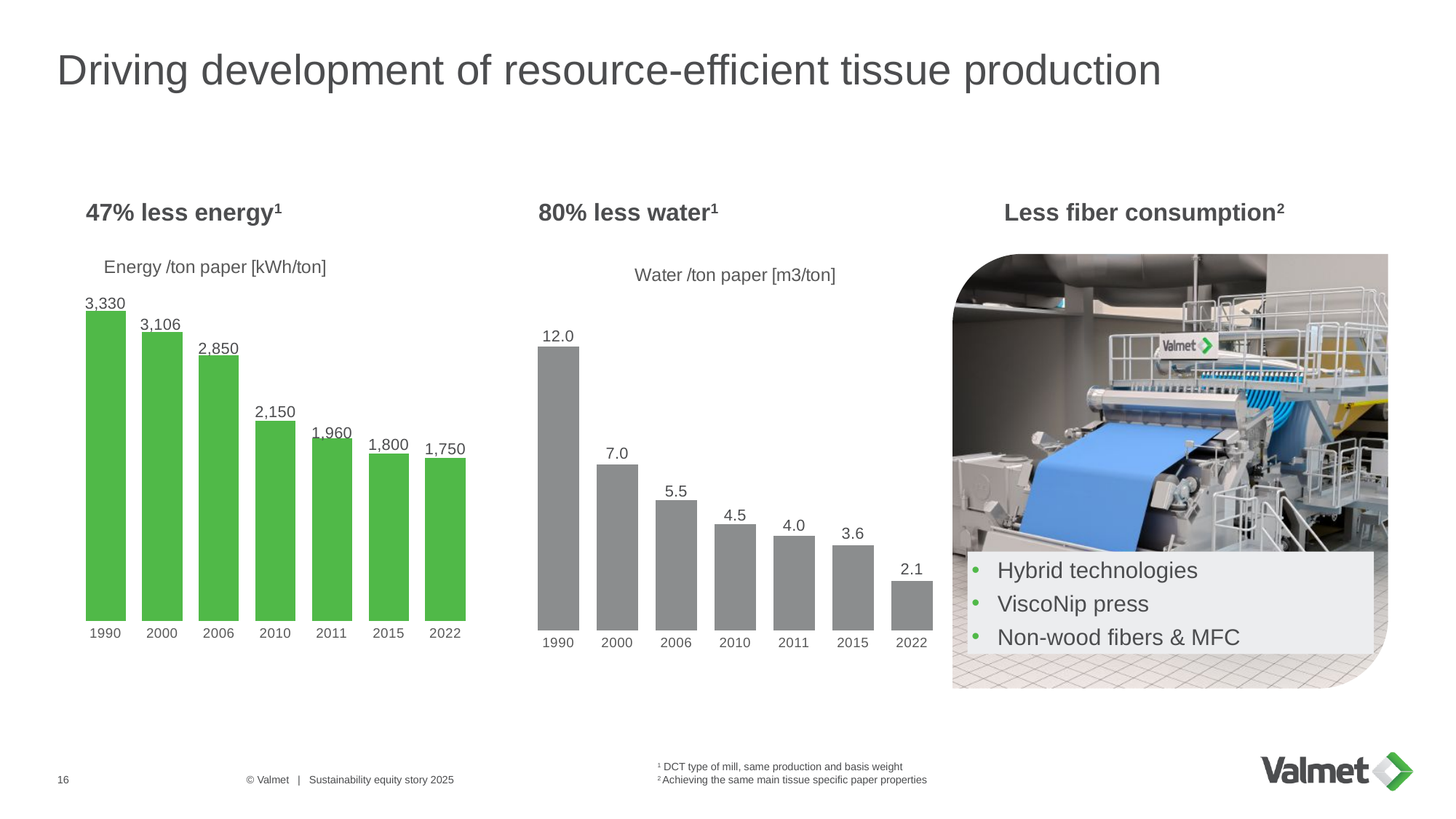
In the 'Energy /ton paper [kWh/ton]' chart, what is the value for 2022? 1,750 In the 'Water /ton paper [m3/ton]' chart, what is the difference between the values for 1990 and 2000? 5.0 What colour are the bars in the 'Water /ton paper [m3/ton]' chart? grey In the 'Water /ton paper [m3/ton]' chart, which is larger, the value for 2011 or the value for 2015? 2011 How many years are shown in the 'Energy /ton paper [kWh/ton]' chart? 7 In the 'Energy /ton paper [kWh/ton]' chart, which year has the highest value? 1990 What kind of chart is the 'Water /ton paper [m3/ton]' chart? bar chart In the 'Water /ton paper [m3/ton]' chart, which year has the lowest value? 2022 In the 'Energy /ton paper [kWh/ton]' chart, what is the value for 1990? 3,330 In the 'Water /ton paper [m3/ton]' chart, what is the value for 2006? 5.5 In the 'Energy /ton paper [kWh/ton]' chart, do the values rise or fall from 1990 to 2022? fall In the 'Energy /ton paper [kWh/ton]' chart, what is the difference between the values for 2010 and 2011? 190